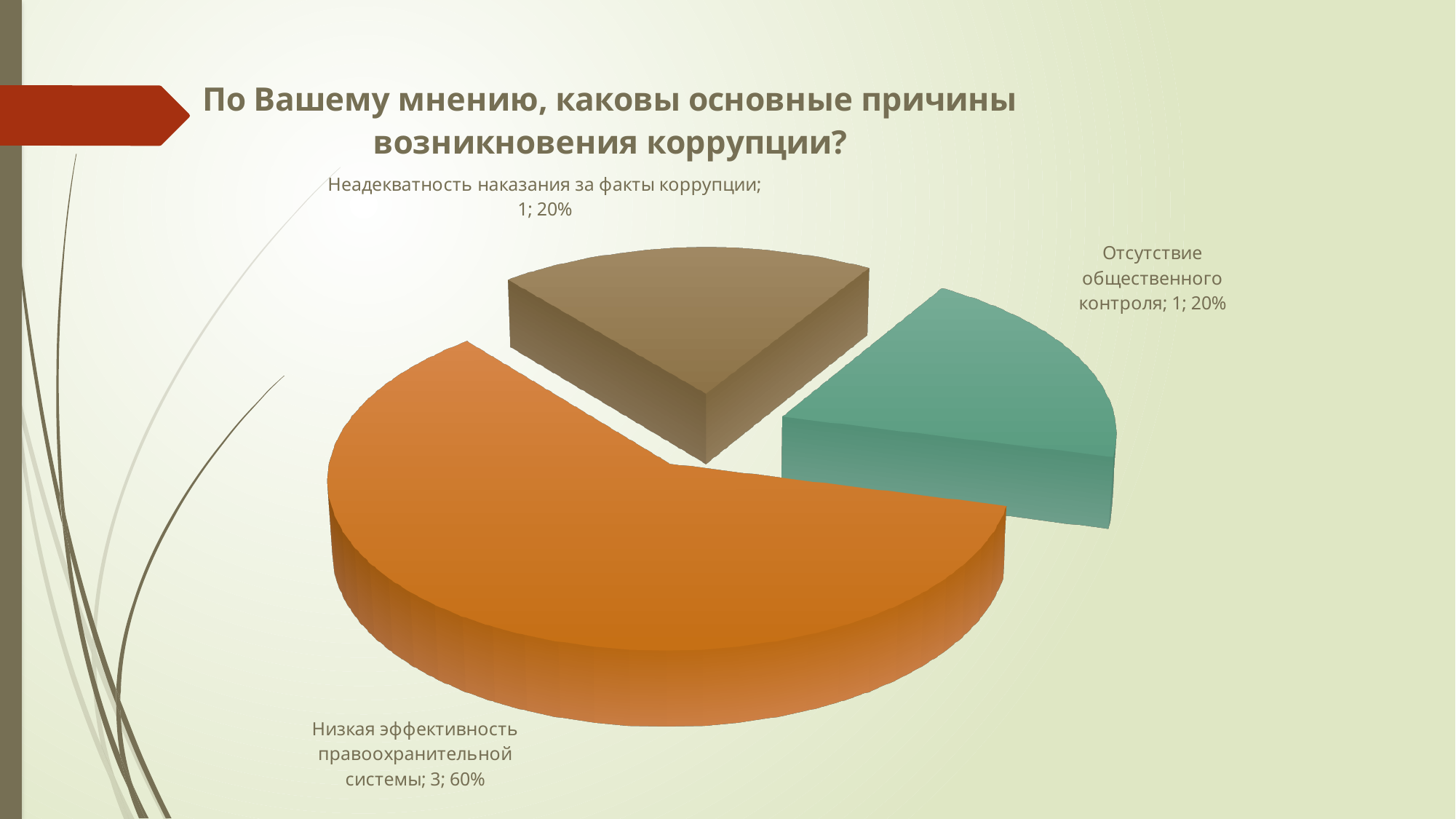
What is the value shown for "Низкая эффективность правоохранительной системы"? 3 What share of the pie does "Отсутствие общественного контроля" have? 20% What kind of chart is shown on the slide? Pie chart What is the difference in value between "Низкая эффективность правоохранительной системы" and "Неадекватность наказания за факты коррупции"? 2 What colour is the slice for "Отсутствие общественного контроля"? Teal (green) Which is larger: the value for "Низкая эффективность правоохранительной системы" or for "Отсутствие общественного контроля"? Низкая эффективность правоохранительной системы How many slices does the pie chart have? 3 Which category has the largest slice of the pie? Низкая эффективность правоохранительной системы What share of the pie does "Низкая эффективность правоохранительной системы" have? 60% What is the value shown for "Отсутствие общественного контроля"? 1 What share of the pie does "Неадекватность наказания за факты коррупции" have? 20% What is the title of the chart on the slide? По Вашему мнению, каковы основные причины возникновения коррупции?